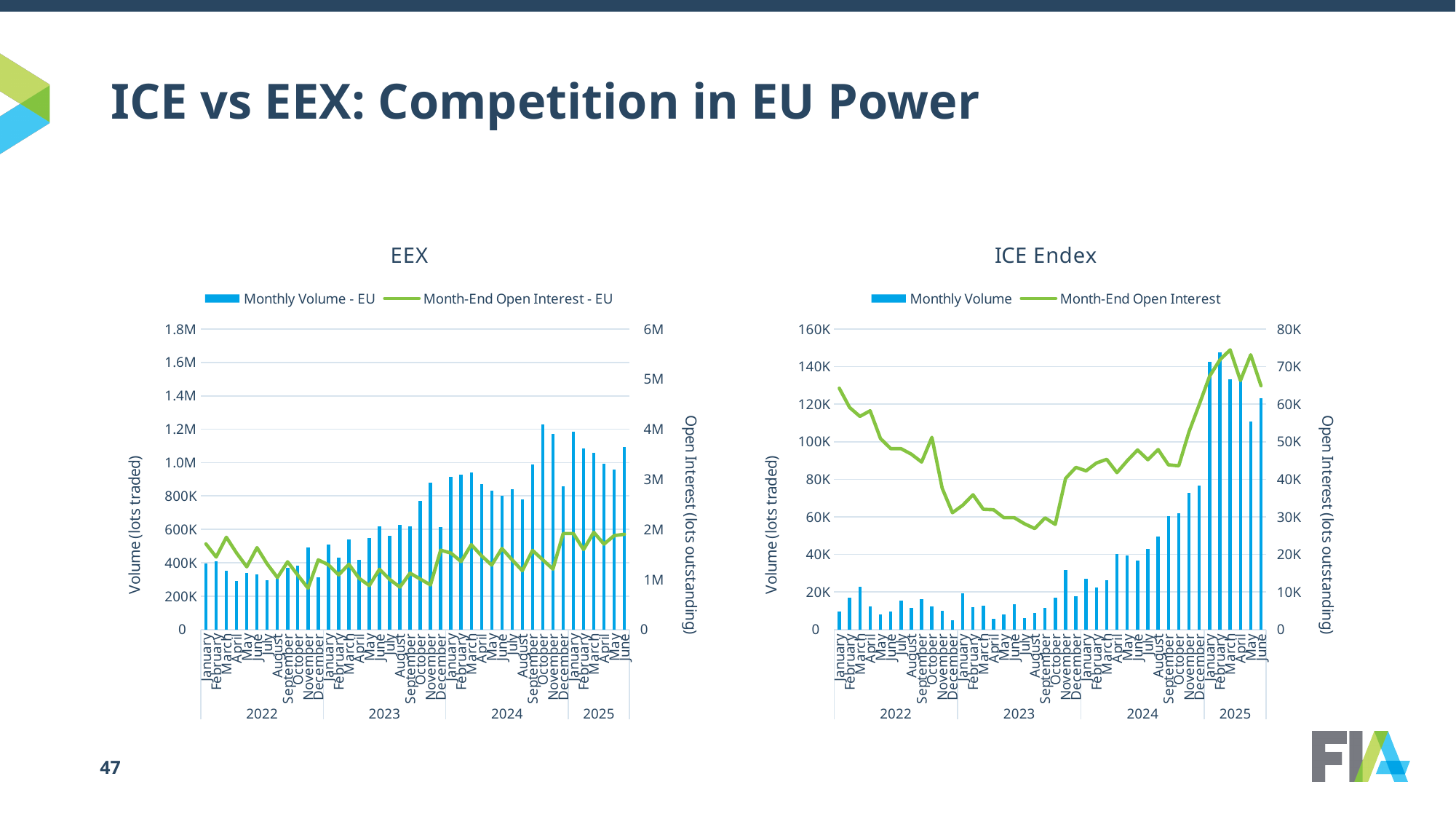
In the ICE Endex chart, is the Monthly Volume for January 2025 greater or less than 120K? greater In the EEX chart, is the Monthly Volume - EU for October 2024 greater or less than 1.0M? greater What kind of chart is the EEX chart? Combined bar and line chart In the ICE Endex chart, does the Month-End Open Interest rise or fall from January 2022 to July 2023? fall In the ICE Endex chart, what is the title of the right-hand vertical axis? Open Interest (lots outstanding) In the EEX chart, is the Month-End Open Interest - EU for January 2022 greater or less than 3M? less In the EEX chart, which series is drawn as a green line? Month-End Open Interest - EU In the ICE Endex chart, does the Monthly Volume generally rise or fall across 2024? rise How many series does the legend of the ICE Endex chart list? 2